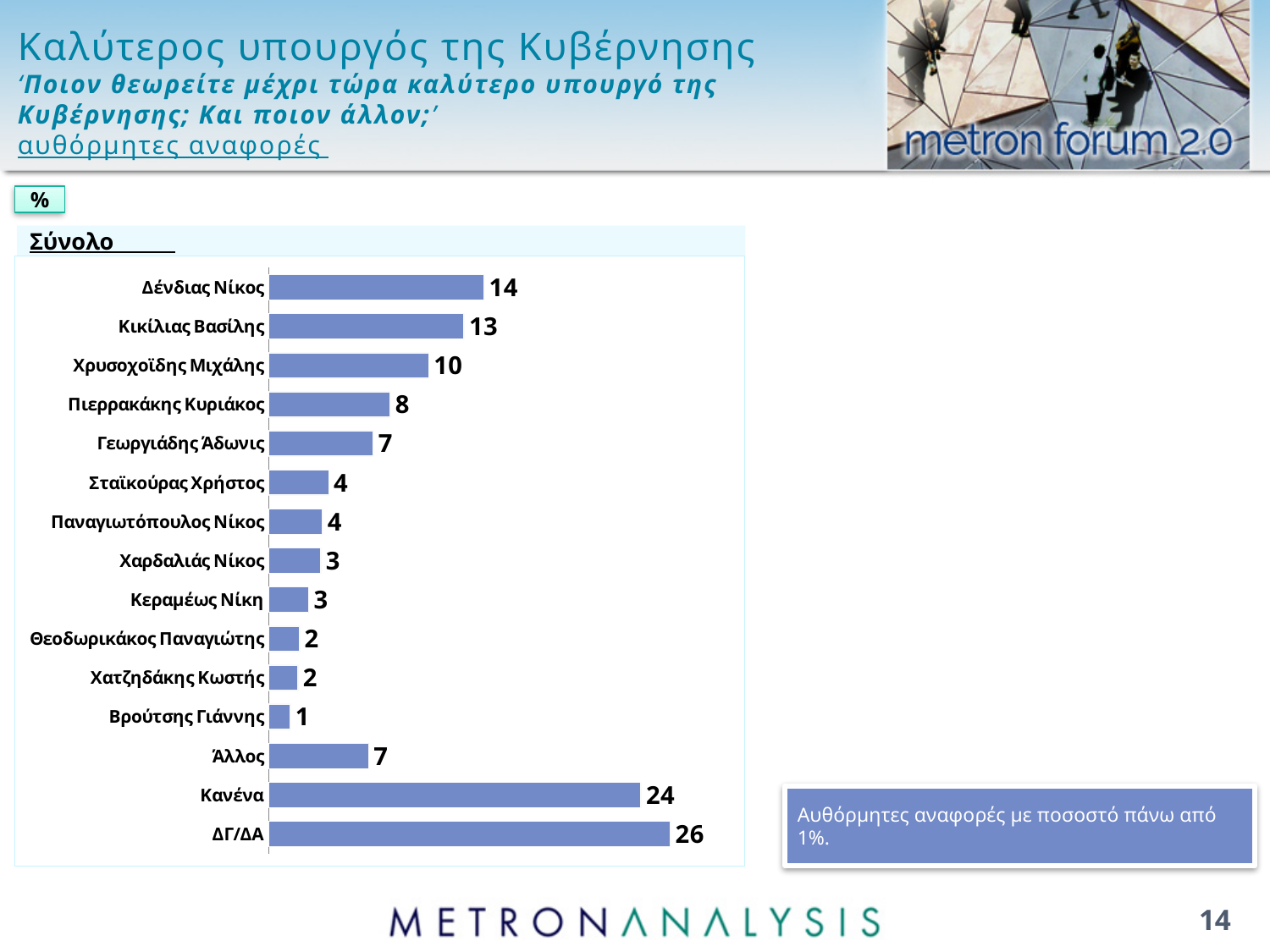
How many categories are shown in the chart? 15 What value is shown for Χρυσοχοΐδης Μιχάλης? 10 Which has a larger value, Πιερρακάκης Κυριάκος or Γεωργιάδης Άδωνις? Πιερρακάκης Κυριάκος What value is shown for Κανένα? 24 What is the heading shown above the chart? Σύνολο Which category has the highest value in the chart? ΔΓ/ΔΑ What value is shown for Δένδιας Νίκος? 14 What is the difference between the values for Δένδιας Νίκος and Κικίλιας Βασίλης? 1 What value is shown for Βρούτσης Γιάννης? 1 What type of chart is shown on the slide? Bar chart What is the difference between the values for ΔΓ/ΔΑ and Κανένα? 2 Which category has the lowest value in the chart? Βρούτσης Γιάννης